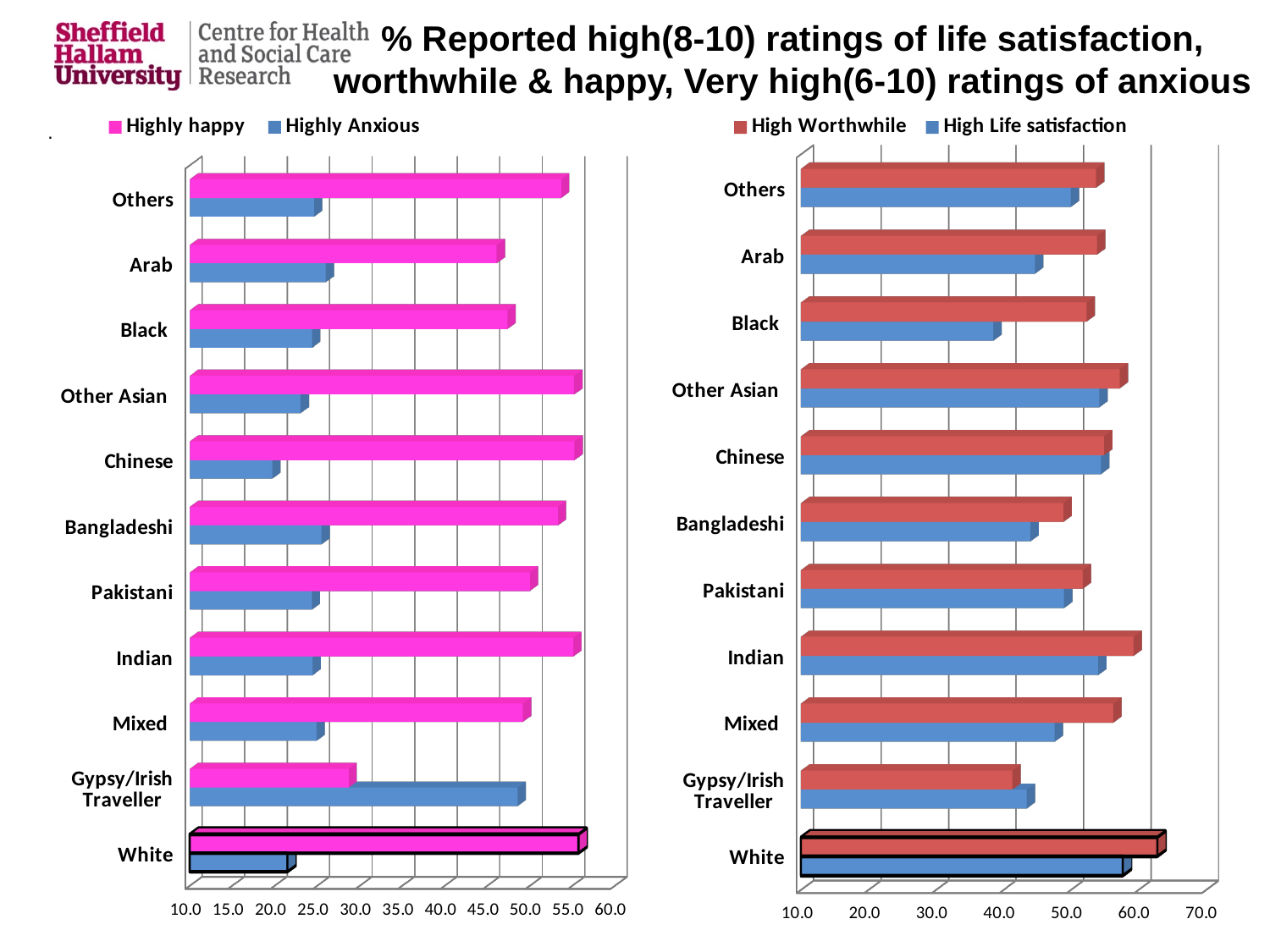
What kind of chart is the left chart (Highly happy / Highly Anxious)? bar chart On the left chart, which category has the lowest Highly happy value? Gypsy/Irish Traveller On the right chart, for Black, which is larger: the High Worthwhile value or the High Life satisfaction value? High Worthwhile On the right chart, which category has the lowest High Life satisfaction value? Black On the right chart, is the High Worthwhile value for Gypsy/Irish Traveller greater or less than 50.0? less On the left chart, for Gypsy/Irish Traveller, which is larger: the Highly happy value or the Highly Anxious value? Highly Anxious On the left chart, is the Highly Anxious value for Gypsy/Irish Traveller greater or less than 45.0? greater On the right chart, which category has the highest High Worthwhile value? White On the left chart, is the Highly happy value for Chinese greater or less than 50.0? greater How many ethnic group categories are shown on the left chart (Highly happy / Highly Anxious)? 11 How many series does the legend of the right chart (High Worthwhile / High Life satisfaction) list? 2 On the left chart, which category has the highest Highly Anxious value? Gypsy/Irish Traveller